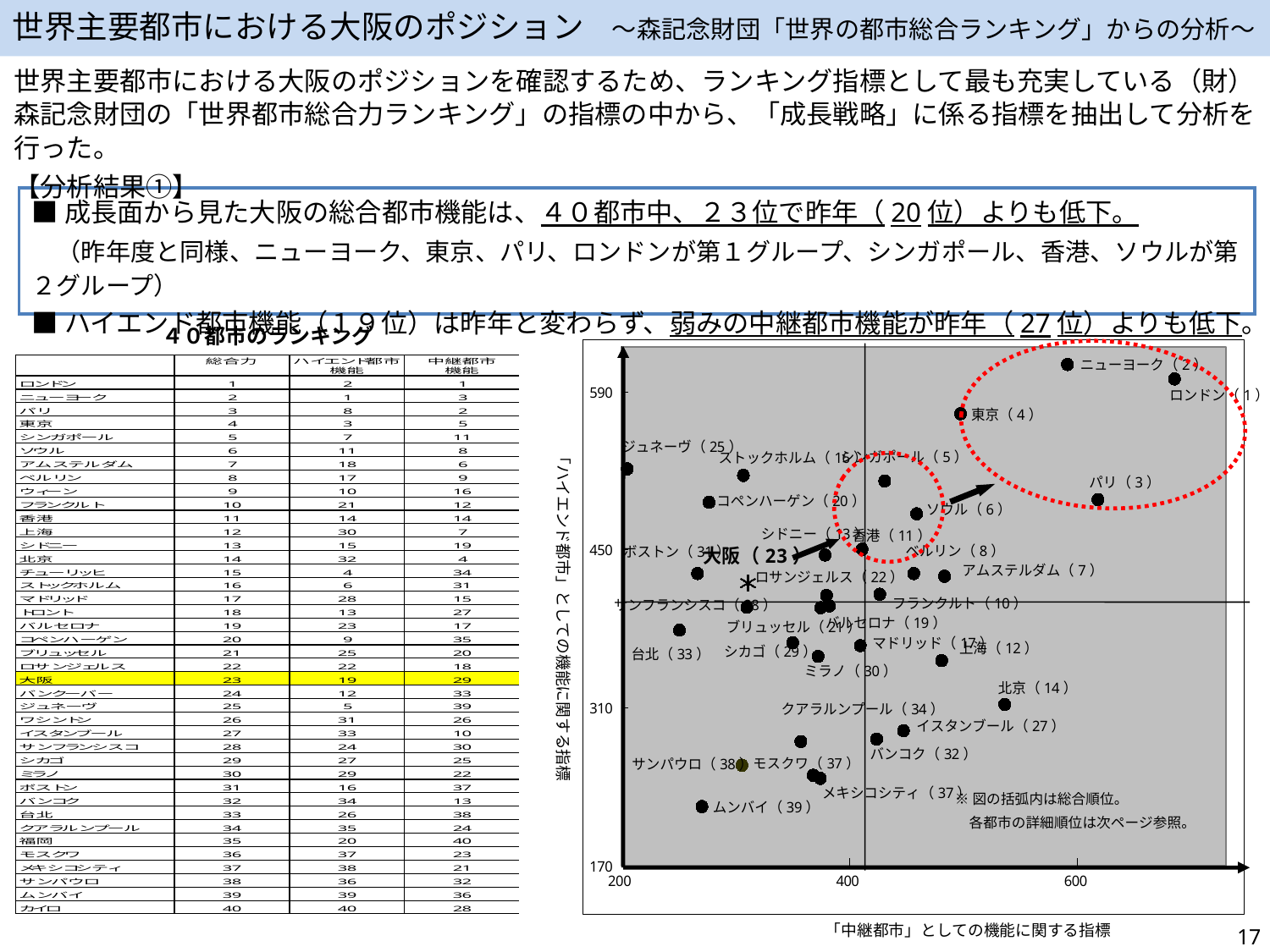
In the scatter chart, is the horizontal-axis value for ニューヨーク greater or less than 600? greater In the scatter chart, which city has the higher vertical-axis value, ニューヨーク or ムンバイ? ニューヨーク What is the label of the horizontal axis of the scatter chart? 「中継都市」としての機能に関する指標 In the scatter chart, is the vertical-axis value for ムンバイ greater or less than 310? less What kind of chart is shown on the right side of the slide? scatter chart In the scatter chart, is the vertical-axis value for ニューヨーク greater or less than 590? greater In the scatter chart, what overall rank is shown in parentheses next to 大阪? 23 In the scatter chart, which city is plotted highest on the vertical axis? ニューヨーク In the scatter chart, which city is plotted furthest left on the horizontal axis? ジュネーヴ